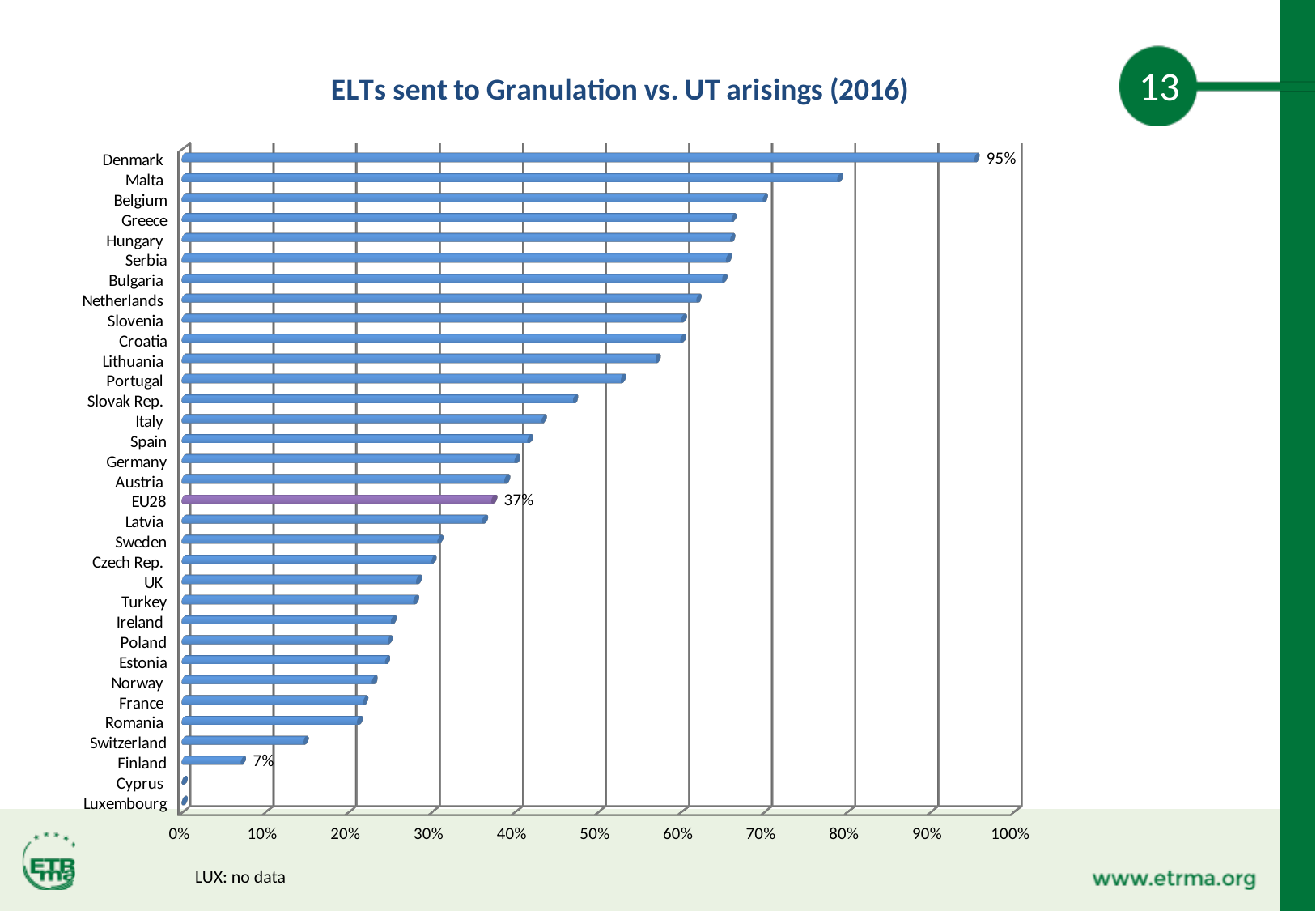
Is the value for Switzerland greater or less than 20%? less What is the difference between the values for Denmark and EU28? 58 percentage points What is the value shown for EU28? 37% How many categories are listed on the vertical axis of the chart? 33 Which country has the highest value in the chart? Denmark What type of chart is shown on the slide? bar chart Is the value for Malta greater or less than 70%? greater What is the title of the chart? ELTs sent to Granulation vs. UT arisings (2016) Which bar is shown in a different colour (purple) from the others? EU28 Which has the larger value, Malta or Belgium? Malta What is the value shown for Denmark? 95% What is the value shown for Finland? 7%